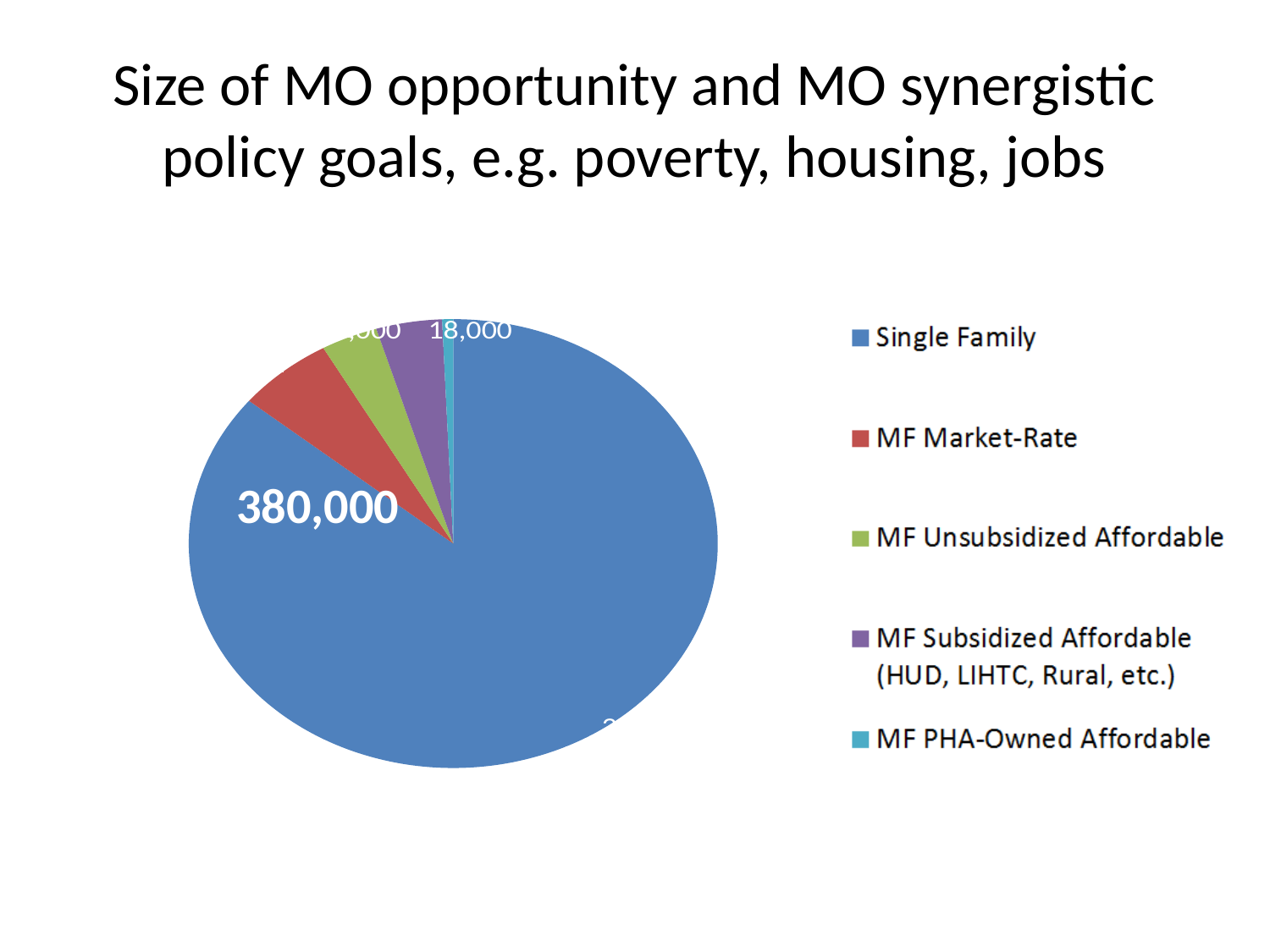
Which slice is larger, MF Subsidized Affordable (HUD, LIHTC, Rural, etc.) or MF PHA-Owned Affordable? MF Subsidized Affordable (HUD, LIHTC, Rural, etc.) Does the Single Family slice make up more or less than half of the pie chart? more What colour is the Single Family slice in the pie chart? blue Which category has the smallest slice of the pie chart? MF PHA-Owned Affordable Which slice is larger, Single Family or MF Market-Rate? Single Family How many categories does the legend of the pie chart list? 5 What kind of chart is shown on the slide? pie chart Which category has the largest slice of the pie chart? Single Family What is the title of the slide containing the pie chart? Size of MO opportunity and MO synergistic policy goals, e.g. poverty, housing, jobs Which slice is larger, MF Market-Rate or MF Unsubsidized Affordable? MF Market-Rate